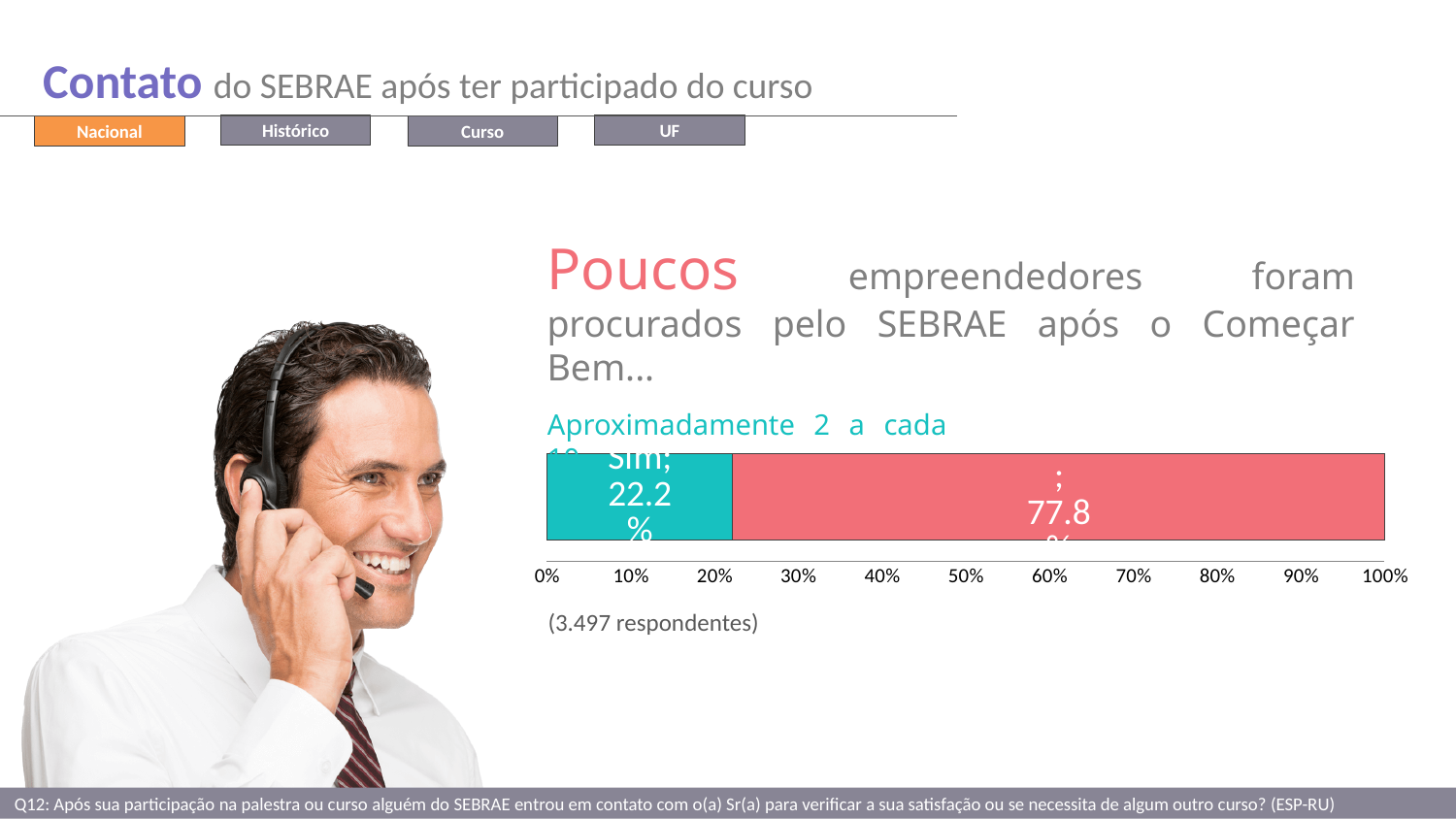
What do the two segments of the stacked bar add up to? 100% What kind of chart is shown on the slide? bar chart Is the value for "Sim" greater or less than 30%? less How many segments does the stacked bar have? 2 What is the highest value shown on the chart's x axis? 100% Is the value of the red segment greater or less than 70%? greater What is the difference between the red segment's value and the "Sim" segment's value? 55.6% What percentage is shown for the "Sim" segment of the bar? 22.2% What percentage is shown for the red segment of the bar? 77.8% Which segment of the bar has the smallest value? Sim Which segment of the bar is larger, the "Sim" segment or the red segment? the red segment How many respondents does the note below the chart report? 3.497 respondentes